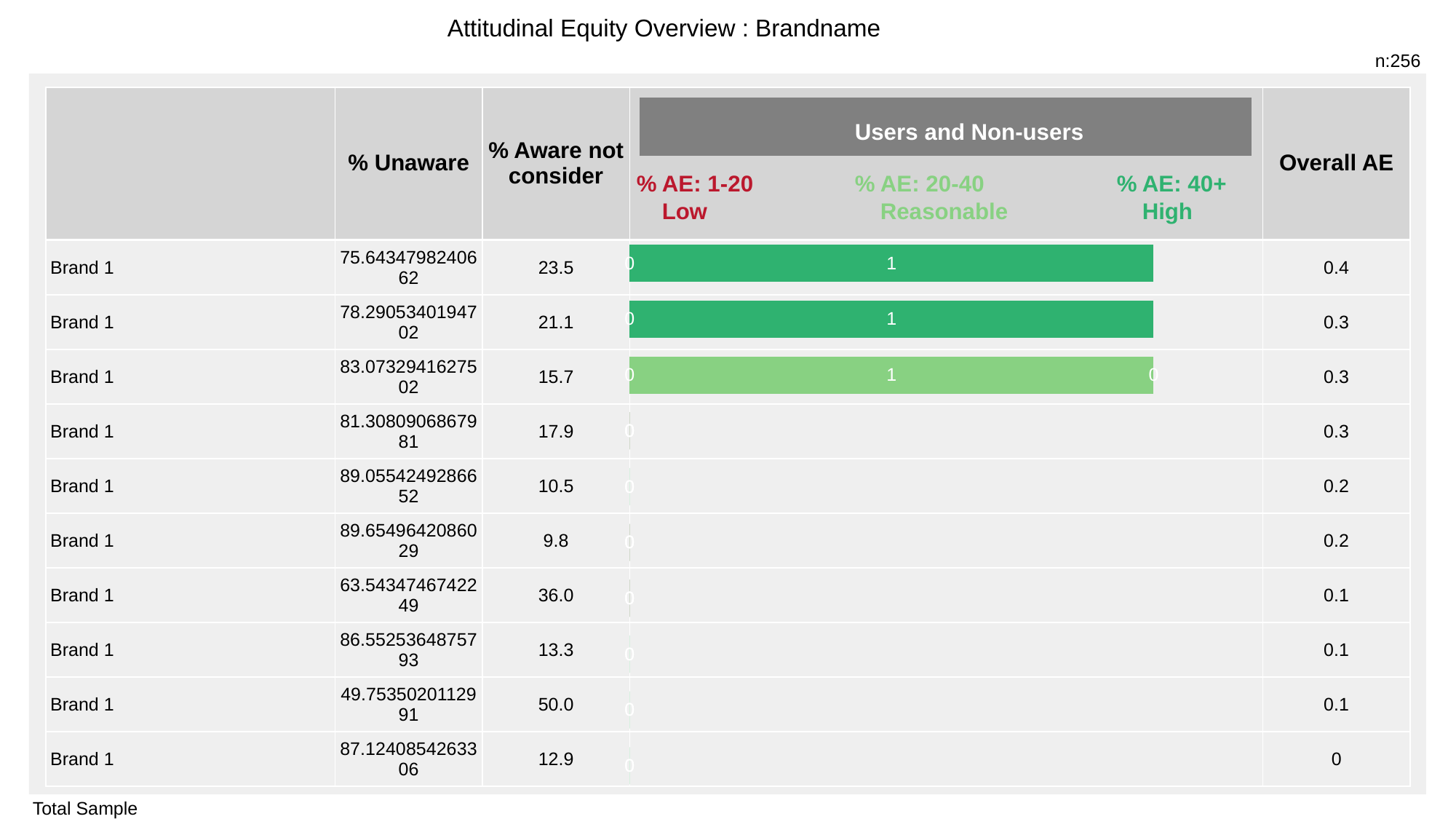
What is the Overall AE value for the last row? 0 What value label is printed at the start of the bar in the fourth row of the chart? 0 Which AE band label corresponds to '% AE: 40+'? High What is the heading printed above the bars in the chart section? Users and Non-users How many rows (bars) does the chart section contain? 10 Is the bar in the first row of the chart longer or shorter than the bar in the fifth row? longer How many rows in the chart section show a visible coloured bar? 3 Do the Overall AE values rise or fall going down the rows of the table? fall How many AE bands are listed in the chart header (Low, Reasonable, High)? 3 What value label is printed on the bar in the first row of the chart? 1 What kind of chart is shown in the 'Users and Non-users' section of the table? bar chart What is the Overall AE value for the first row? 0.4